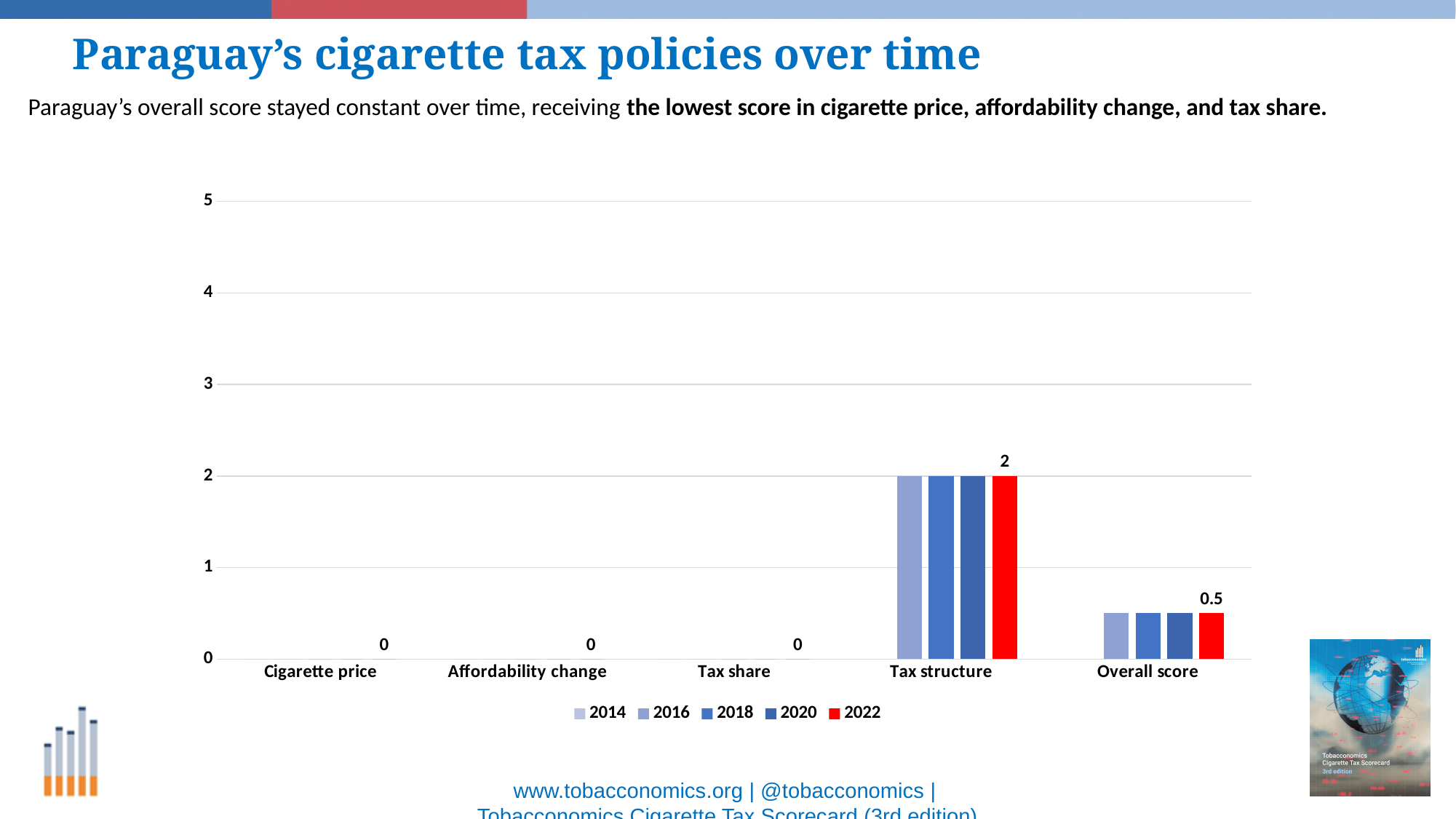
What is the 2022 value for Overall score? 0.5 Which colour represents 2022 in the legend? red What is the difference between the 2022 values for Tax structure and Overall score? 1.5 What kind of chart is shown on the slide? bar chart Which is larger in 2022: Tax structure or Overall score? Tax structure Is the 2022 value for Tax structure greater or less than 3? less How many series does the legend list? 5 How many categories are shown on the x axis? 5 Which category has the highest value in 2022? Tax structure What is the 2022 value for Tax structure? 2 What is the 2022 value for Tax share? 0 What is the 2022 value for Cigarette price? 0